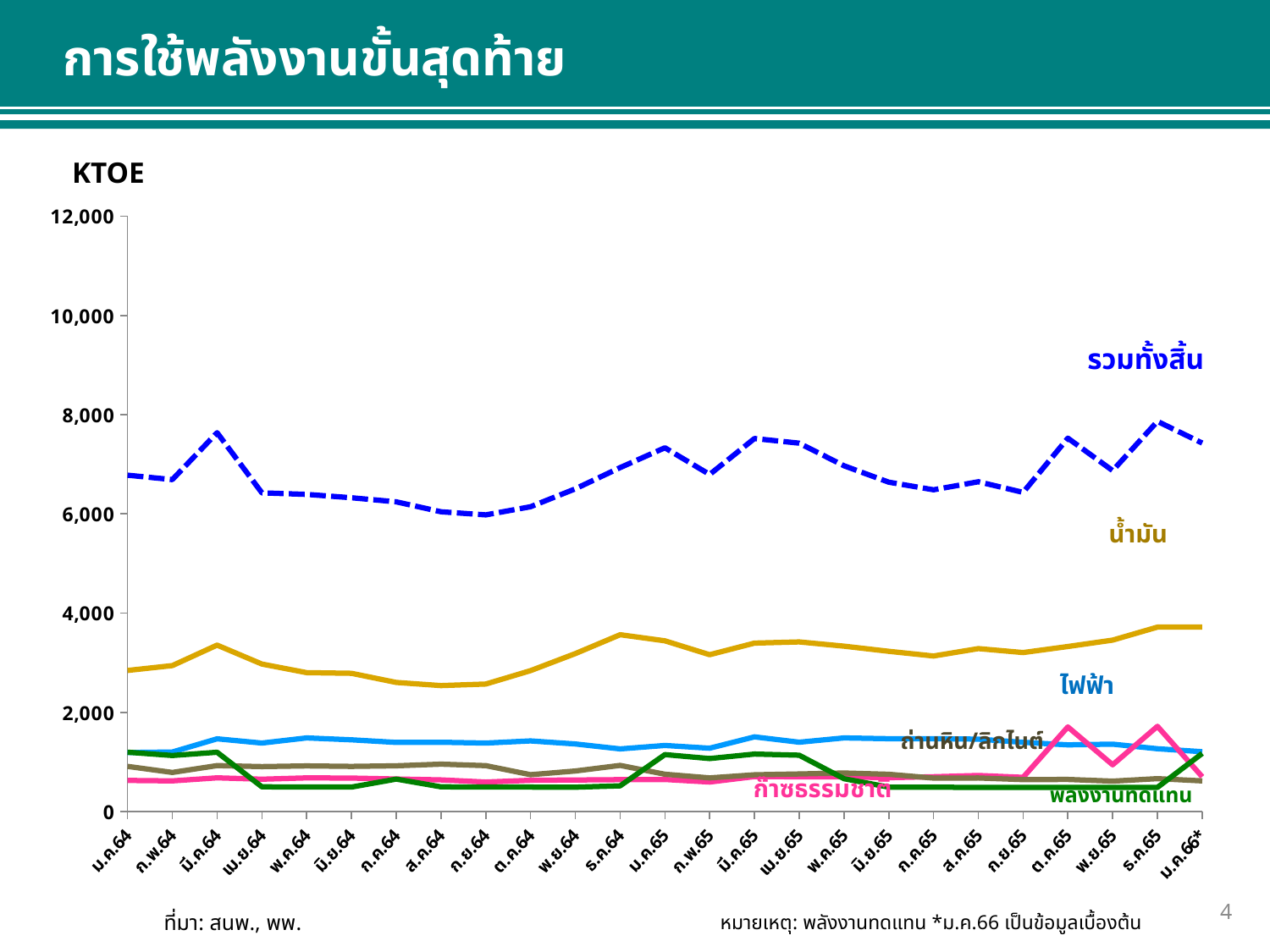
What unit is shown above the y-axis of the chart? KTOE Is the value for รวมทั้งสิ้น in ม.ค.64 greater or less than 6,000? greater Is the value for ไฟฟ้า in ม.ค.65 greater or less than 2,000? less Is the value for ก๊าซธรรมชาติ in ต.ค.65 greater or less than 1,000? greater What is the highest value shown on the y-axis of the chart? 12,000 How many months (x-axis categories) are plotted on the chart? 25 In ม.ค.66*, which is larger: น้ำมัน or ไฟฟ้า? น้ำมัน What kind of chart is shown on the slide? line chart How many data series are labelled on the chart? 6 Which series has the highest values across the whole chart? รวมทั้งสิ้น